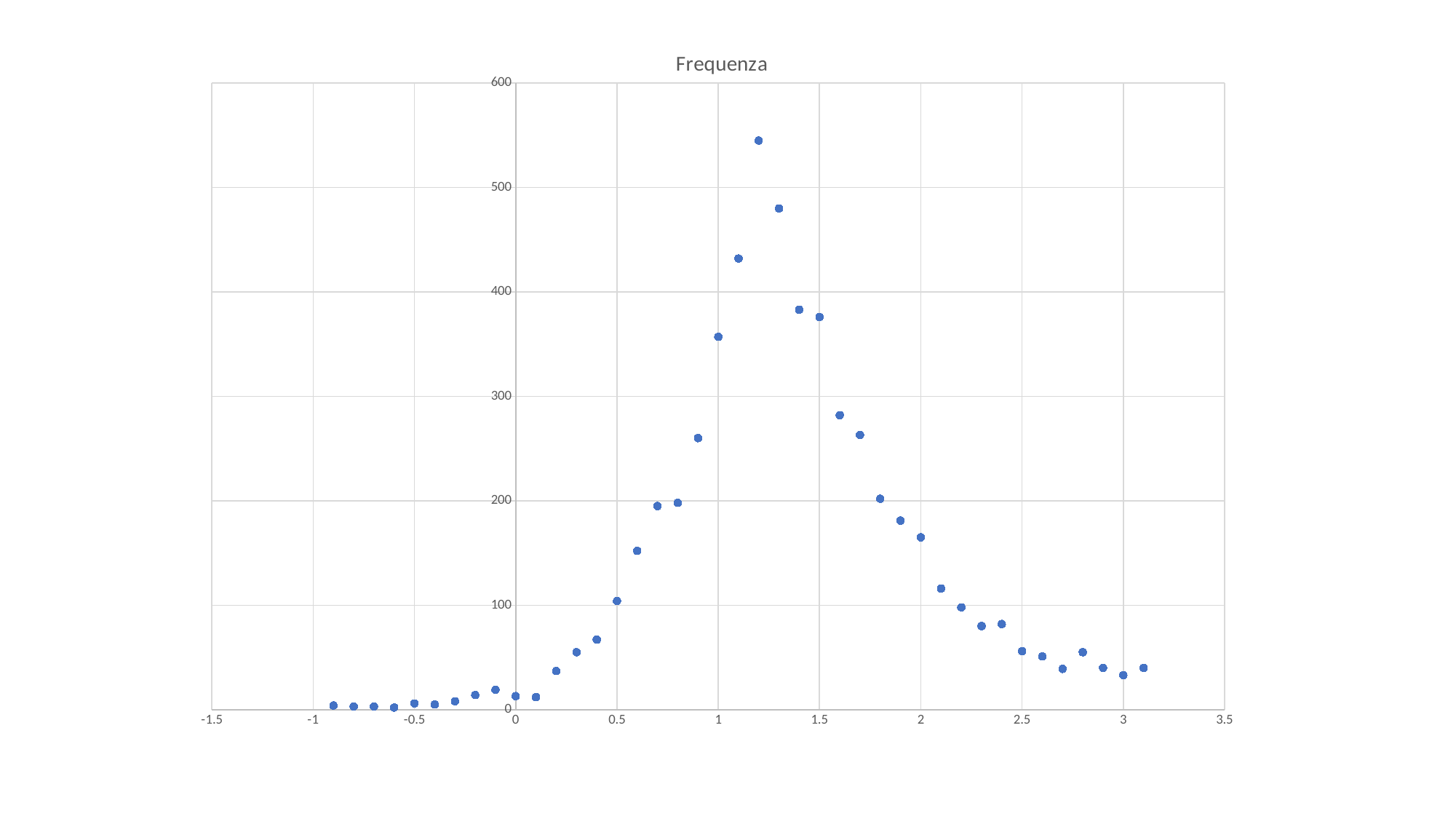
Do the values rise or fall as x increases from 1.2 to 3? fall Is the value at x = 1.2 greater or less than 500? greater Is the value at x = 3 greater or less than 100? less What is the title of the chart? Frequenza Is the value at x = 1 greater or less than 300? greater Which is larger, the value at x = 1.1 or the value at x = 1.3? x = 1.3 Which is larger, the value at x = 2.2 or the value at x = 2.5? x = 2.2 What kind of chart is shown on the slide? scatter chart At which x value does the chart reach its highest point? 1.2